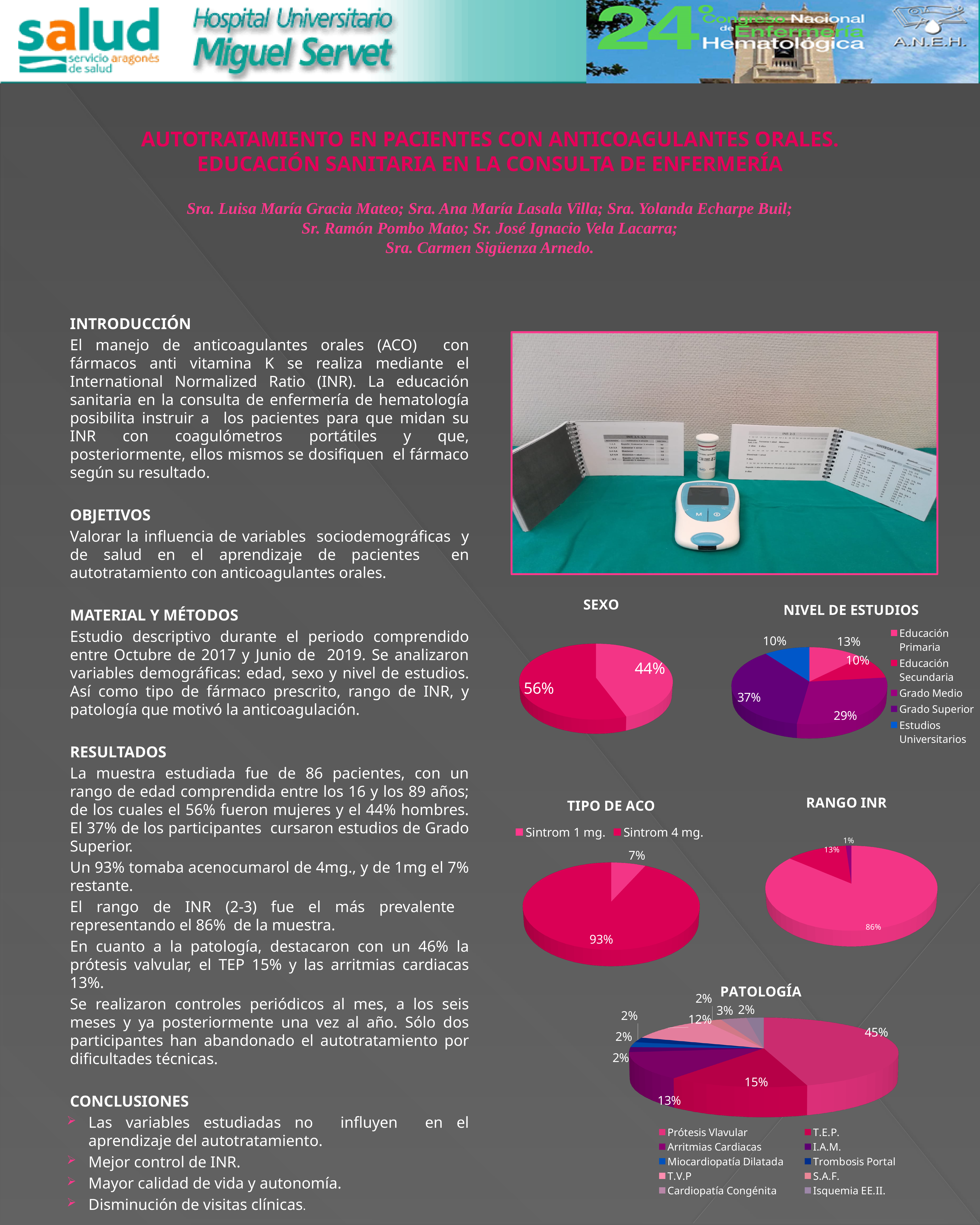
What kind of chart is the PATOLOGÍA chart? Pie chart How many categories does the legend of the NIVEL DE ESTUDIOS chart list? 5 In the SEXO pie chart, what is the value of the smaller slice? 44% In the NIVEL DE ESTUDIOS chart, what share is Grado Medio? 29% In the NIVEL DE ESTUDIOS chart, what share is Grado Superior? 37% In the TIPO DE ACO chart, which is larger, Sintrom 1 mg. or Sintrom 4 mg.? Sintrom 4 mg. In the RANGO INR chart, what is the value of the largest slice? 86% In the NIVEL DE ESTUDIOS chart, which category has the largest share? Grado Superior In the TIPO DE ACO chart, what share is Sintrom 4 mg.? 93% In the SEXO pie chart, what is the value of the largest slice? 56% In the SEXO pie chart, what is the difference between the two slices? 12% In the PATOLOGÍA chart, what share is T.E.P.? 15%